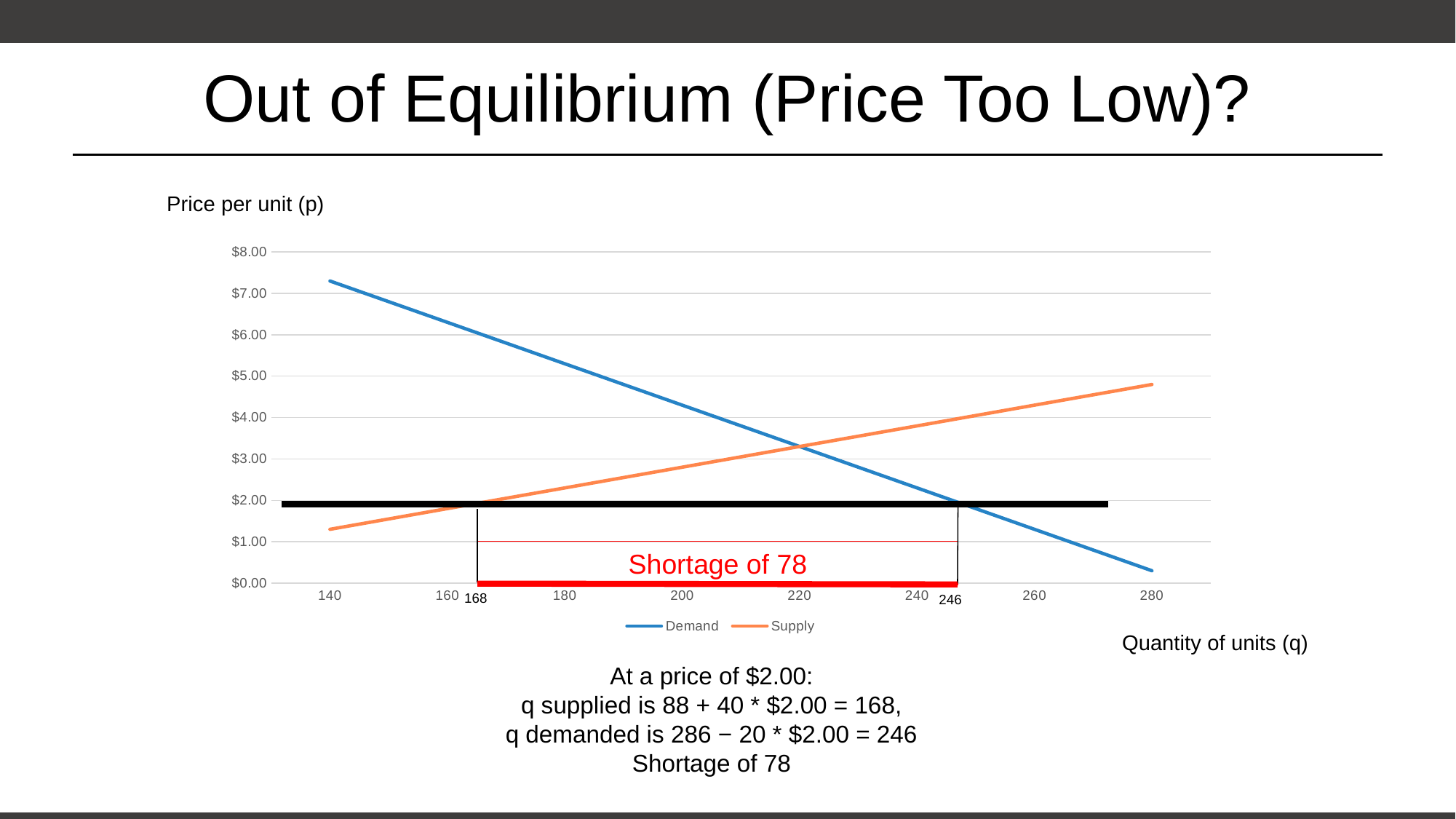
How many series does the chart's legend list? 2 Does the Supply line rise or fall as quantity increases along the x axis? rise At a price of $2.00, what is the quantity demanded shown on the chart? 246 Is the price on the Supply line at a quantity of 280 greater or less than $5.00? less Is the price on the Demand line at a quantity of 140 greater or less than $7.00? greater At a price of $2.00, what is the quantity supplied shown on the chart? 168 At a price of $2.00, which is larger: quantity demanded or quantity supplied? quantity demanded What is the difference between quantity demanded (246) and quantity supplied (168) at a price of $2.00? 78 What are the two series named in the chart's legend? Demand and Supply What kind of chart is shown on the slide? line chart What is the label of the vertical axis of the chart? Price per unit (p) Does the Demand line rise or fall as quantity increases along the x axis? fall